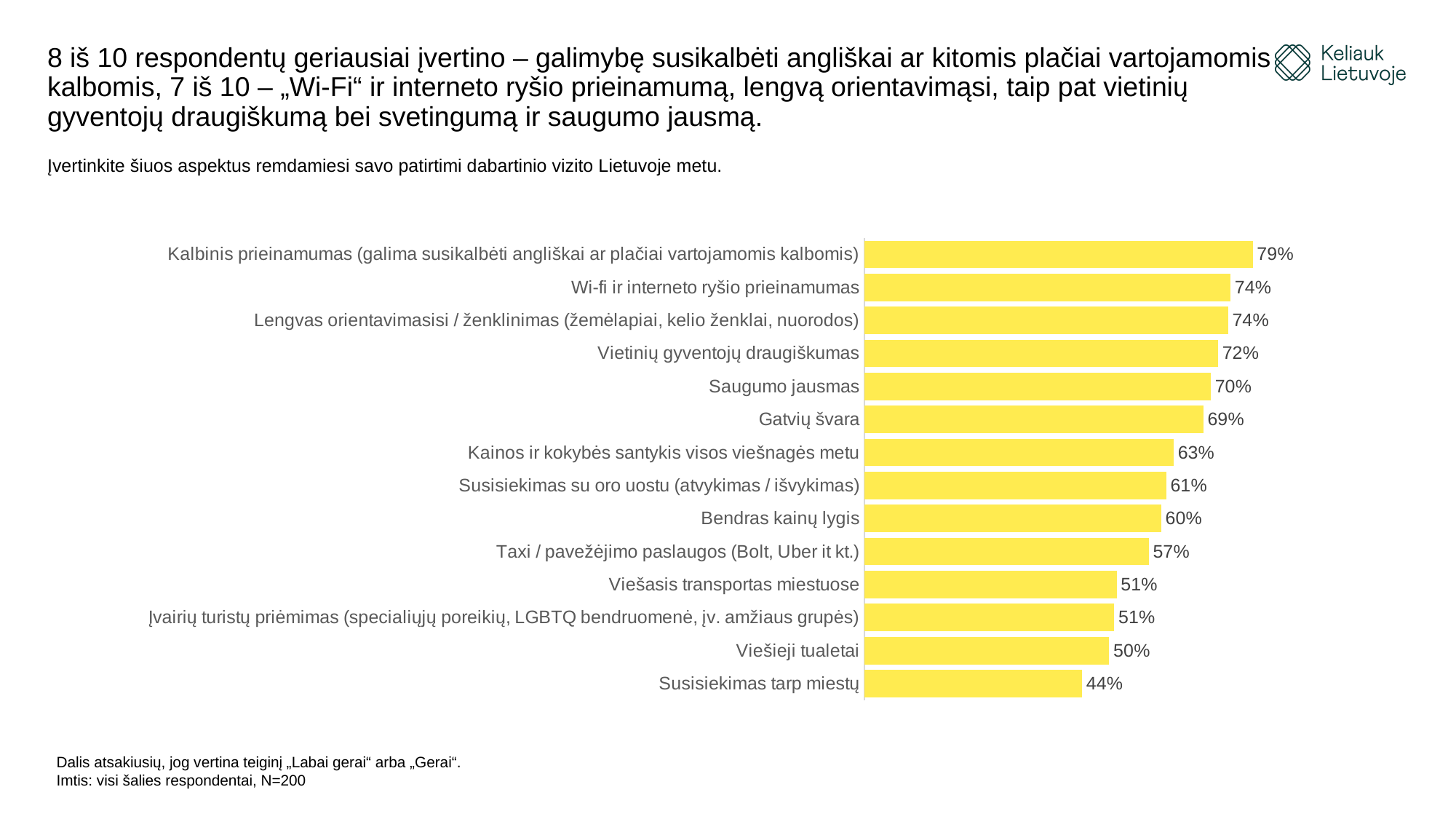
What is the value for "Susisiekimas su oro uostu (atvykimas / išvykimas)"? 61% How many categories are shown in the chart? 14 Which category has the lowest value? Susisiekimas tarp miestų What colour are the bars in the chart? Yellow What kind of chart is shown on the slide? Bar chart What is the value for "Taxi / pavežėjimo paslaugos (Bolt, Uber it kt.)"? 57% What is the difference between the values for "Gatvių švara" and "Bendras kainų lygis"? 9% What is the value for "Saugumo jausmas"? 70% What is the difference between the values for "Kalbinis prieinamumas" and "Susisiekimas tarp miestų"? 35% Which category has the highest value? Kalbinis prieinamumas (galima susikalbėti angliškai ar plačiai vartojamomis kalbomis) Which is larger: the value for "Vietinių gyventojų draugiškumas" or the value for "Kainos ir kokybės santykis visos viešnagės metu"? Vietinių gyventojų draugiškumas What is the value for "Viešieji tualetai"? 50%